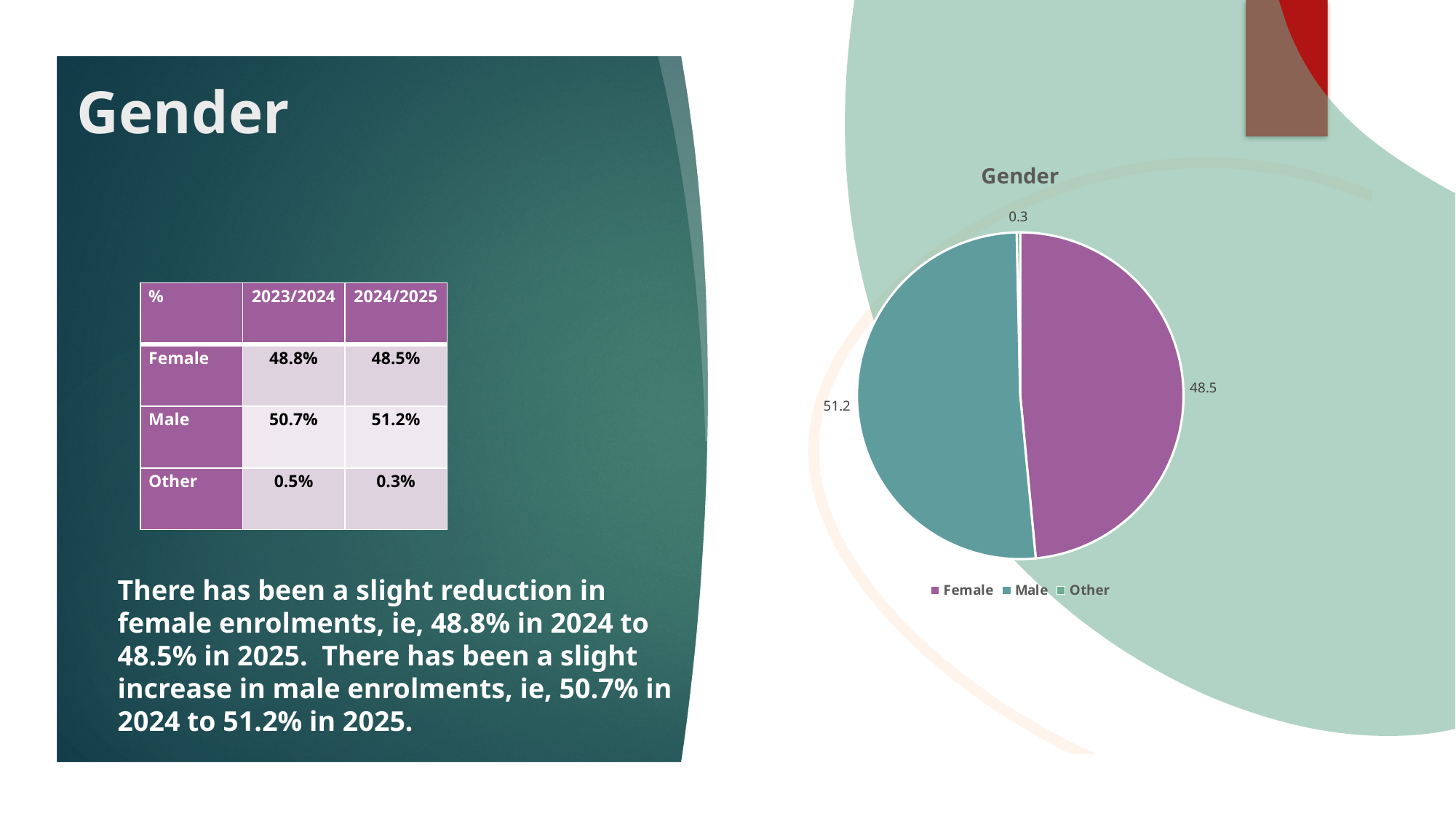
Which category has the largest slice in the pie chart? Male What value is shown for Female in the pie chart? 48.5 How many slices does the pie chart have? 3 What is the chart's title? Gender Which category has the smallest slice in the pie chart? Other What value is shown for Male in the pie chart? 51.2 What type of chart is shown on the slide? pie chart Which is larger in the pie chart, Female or Other? Female What value is shown for Other in the pie chart? 0.3 What colour is the Female slice in the pie chart? purple What is the difference between the Male and Female values in the pie chart? 2.7 How many entries does the legend list? 3